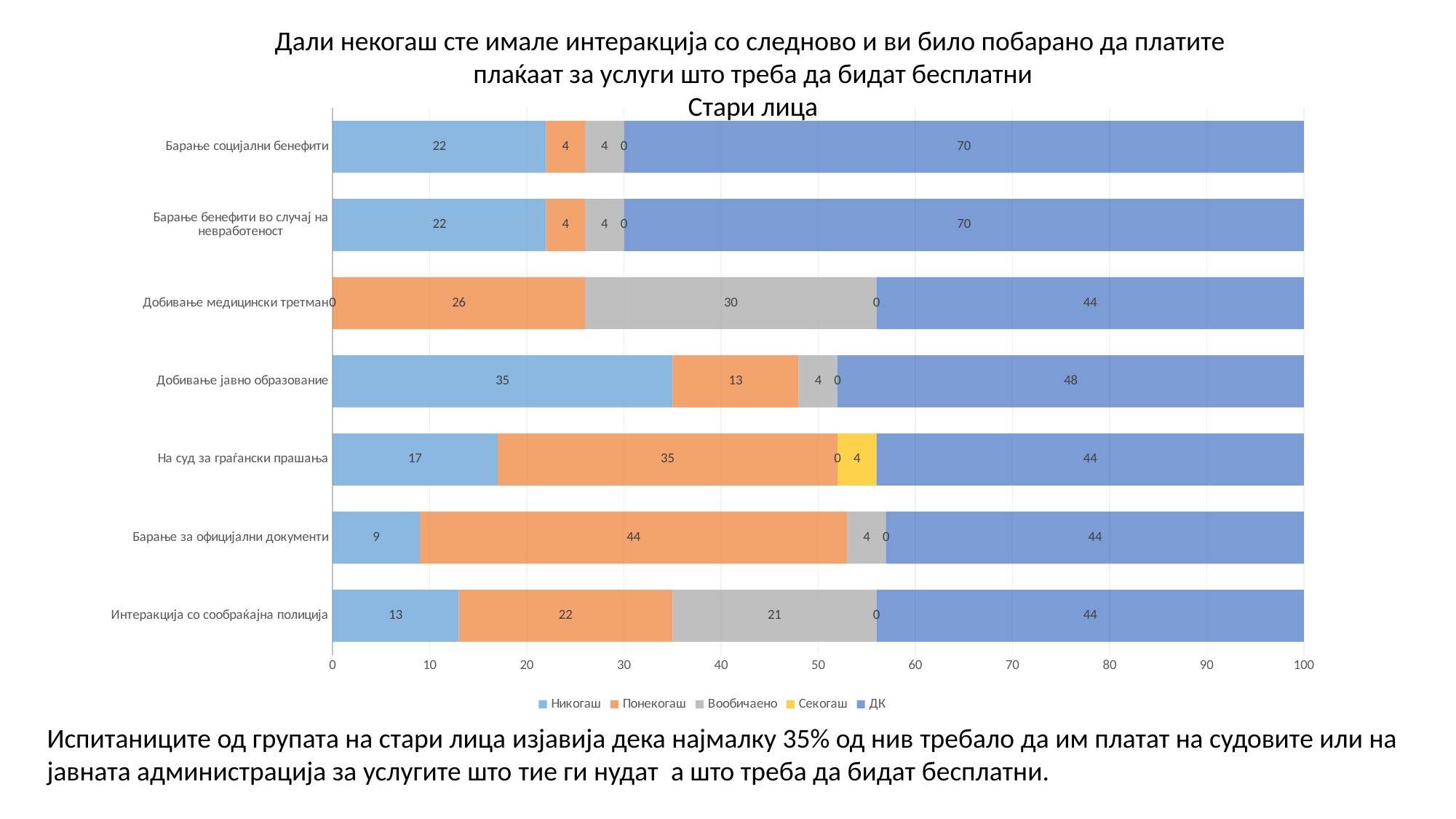
Which category has the highest value for Понекогаш? Барање за официјални документи How many categories are plotted on the chart? 7 What is the value of Вообичаено for Добивање медицински третман? 30 How many series does the legend list? 5 What is the total of the stacked bar for Добивање јавно образование? 100 What is the value of Секогаш for На суд за граѓански прашања? 4 What is the value of Понекогаш for Барање за официјални документи? 44 Which has the larger Вообичаено value: Добивање медицински третман or Интеракција со сообраќајна полиција? Добивање медицински третман What is the difference between the Понекогаш values for На суд за граѓански прашања and Интеракција со сообраќајна полиција? 13 What kind of chart is shown on the slide? Bar chart Which category has the highest value for Никогаш? Добивање јавно образование What is the value of ДК for Барање социјални бенефити? 70